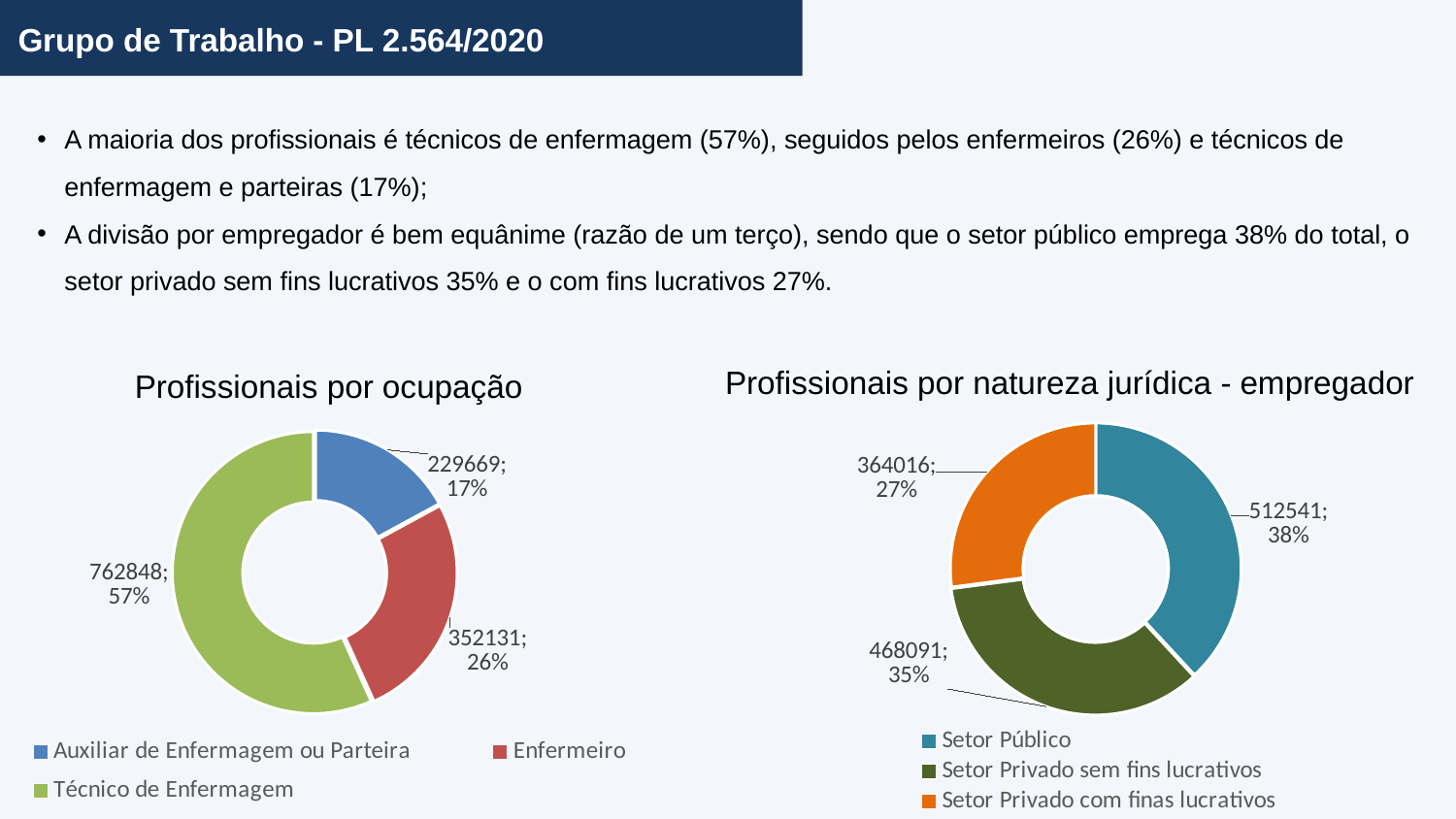
In the chart 'Profissionais por natureza jurídica - empregador', what is the difference between the values for Setor Público and Setor Privado sem fins lucrativos? 44450 In the chart 'Profissionais por natureza jurídica - empregador', what percentage share does Setor Privado com finas lucrativos have? 27% In the chart 'Profissionais por ocupação', what value is shown for Técnico de Enfermagem? 762848 What kind of chart is 'Profissionais por ocupação'? Pie (doughnut) chart In the chart 'Profissionais por ocupação', what is the difference between the values for Técnico de Enfermagem and Enfermeiro? 410717 In the chart 'Profissionais por natureza jurídica - empregador', which category has the largest value? Setor Público In the chart 'Profissionais por ocupação', what percentage share does Enfermeiro have? 26% In the chart 'Profissionais por natureza jurídica - empregador', what value is shown for Setor Público? 512541 In the chart 'Profissionais por ocupação', how many categories are shown? 3 In the chart 'Profissionais por ocupação', which category has the smallest share? Auxiliar de Enfermagem ou Parteira In the chart 'Profissionais por natureza jurídica - empregador', what colour is the Setor Público slice? Teal blue In the chart 'Profissionais por natureza jurídica - empregador', which is larger: Setor Privado sem fins lucrativos or Setor Privado com finas lucrativos? Setor Privado sem fins lucrativos